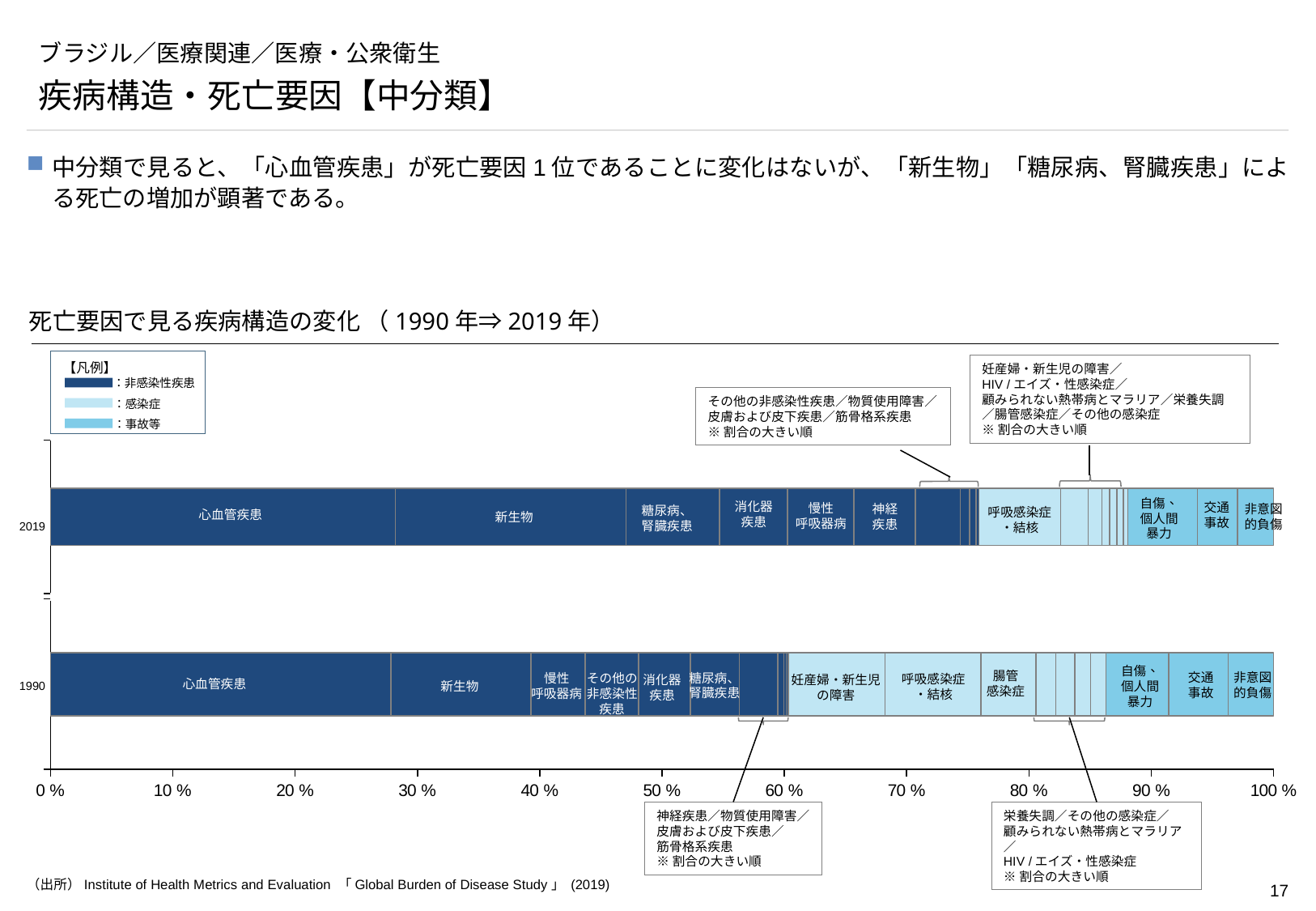
What kind of chart is shown on the slide? Stacked bar chart What is the title of the chart? 死亡要因で見る疾病構造の変化（1990年⇒2019年） How many years (bars) does the chart compare? 2 Which cause of death has the largest share in the 2019 bar? 心血管疾患 Is the share of 妊産婦・新生児の障害 larger in 1990 or in 2019? 1990 Is the combined share of 心血管疾患 and 新生物 in 2019 greater or less than 50%? less Is the share of 心血管疾患 in 2019 greater or less than 30%? less Which legend category is shown in dark blue? 非感染性疾患 In which year do infectious diseases (感染症, light blue) account for a larger share of deaths? 1990 Which cause of death has the largest share in the 1990 bar? 心血管疾患 Is the share of 新生物 larger in 2019 or in 1990? 2019 How many categories does the legend (凡例) list? 3